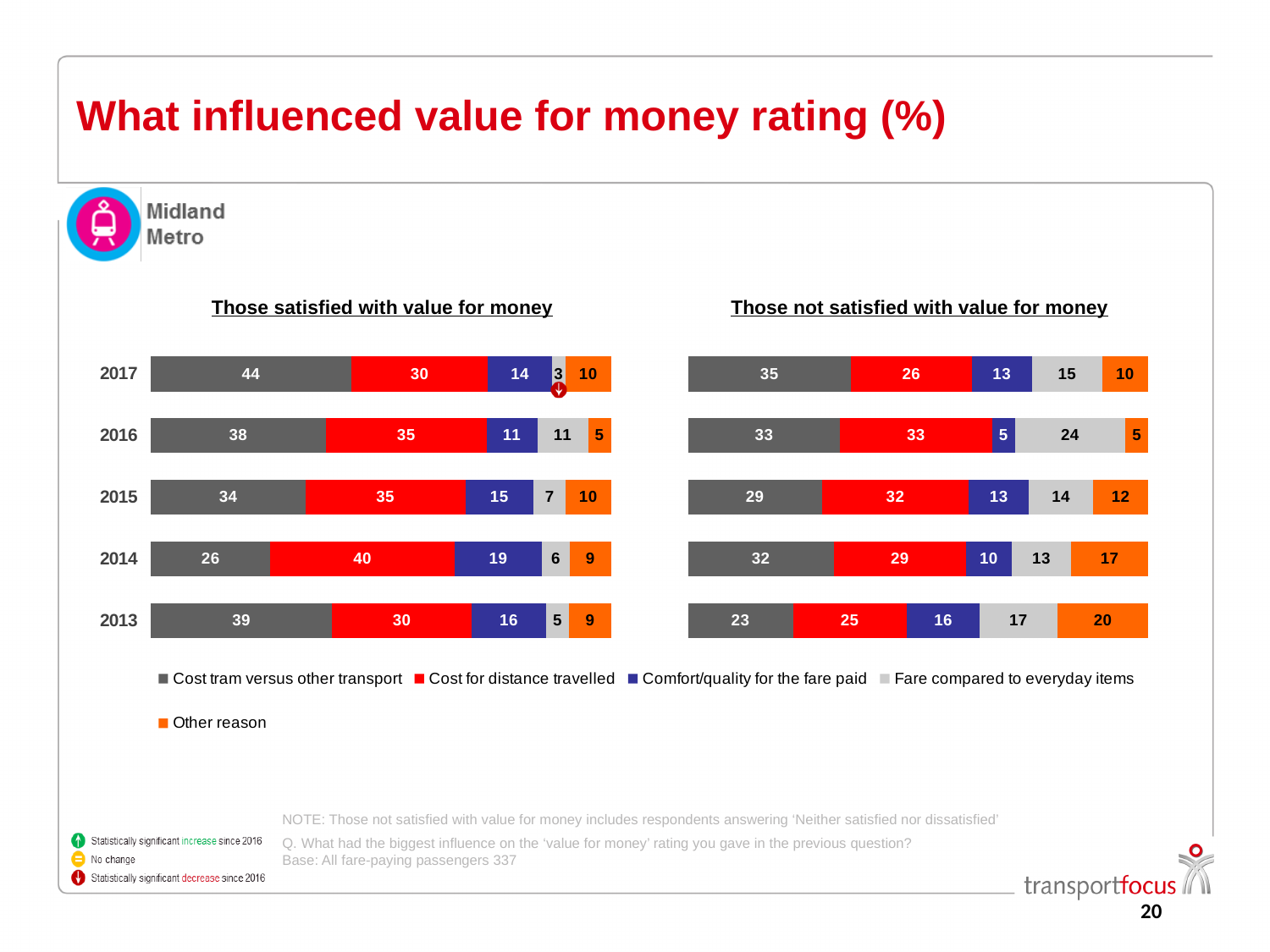
In the 'Those satisfied with value for money' chart, what is the value for 'Cost for distance travelled' in 2014? 40 What kind of chart is used for 'Those not satisfied with value for money'? Stacked bar chart In the 'Those satisfied with value for money' chart, what is the value for 'Cost tram versus other transport' in 2017? 44 In the 'Those not satisfied with value for money' chart, what is the value for 'Other reason' in 2013? 20 In the 'Those not satisfied with value for money' chart, which year has the lowest value for 'Comfort/quality for the fare paid'? 2016 How many series does the legend list? 5 In the 'Those satisfied with value for money' chart, what is the difference between the 'Cost tram versus other transport' values for 2017 and 2016? 6 How many years are shown in the 'Those satisfied with value for money' chart? 5 In the 'Those satisfied with value for money' chart, which year has the highest value for 'Cost tram versus other transport'? 2017 In the 'Those not satisfied with value for money' chart, what is the value for 'Fare compared to everyday items' in 2016? 24 In the 'Those satisfied with value for money' chart, what is the total of the 2017 bar? 101 In the 'Those not satisfied with value for money' chart, which is larger in 2014: 'Cost tram versus other transport' or 'Cost for distance travelled'? Cost tram versus other transport